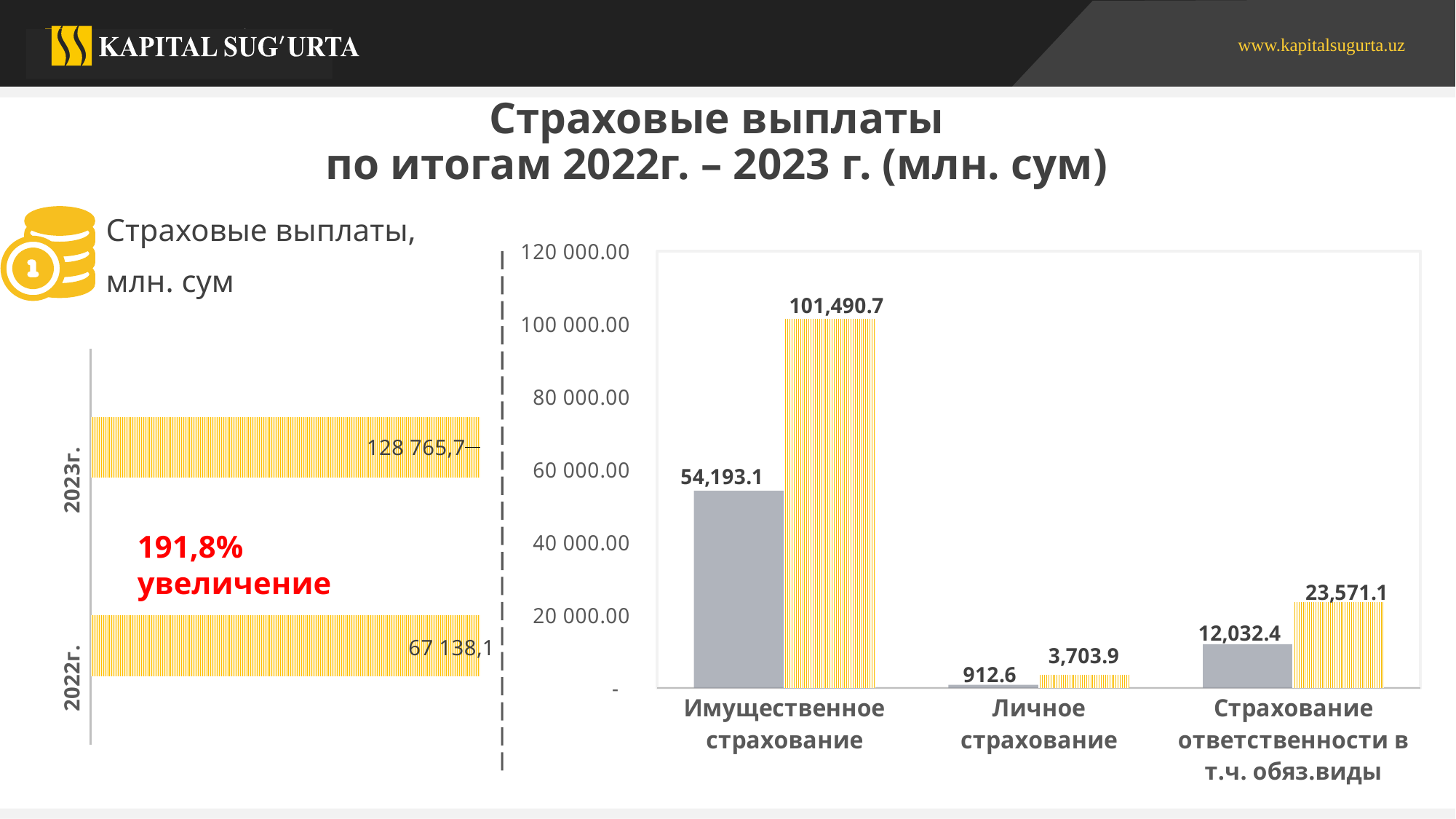
On the left chart, which year has the larger value, 2022г. or 2023г.? 2023г. On the right chart, what is the value of the yellow striped bar for Страхование ответственности в т.ч. обяз.виды? 23,571.1 On the right chart, which category has the highest value overall? Имущественное страхование On the right chart, what is the value of the grey bar for Личное страхование? 912.6 On the right chart, what is the difference between the yellow striped bar and the grey bar for Страхование ответственности в т.ч. обяз.виды? 11,538.7 On the right chart, is the grey bar for Имущественное страхование greater or less than 60 000.00? less On the left chart, what is the value for 2022г.? 67 138,1 On the left chart, what percentage increase is shown in red text? 191,8% On the left chart, how many bars are plotted? 2 What kind of chart is the right chart? bar chart On the left chart, what is the value for 2023г.? 128 765,7 On the right chart, what is the value of the yellow striped bar for Имущественное страхование? 101,490.7